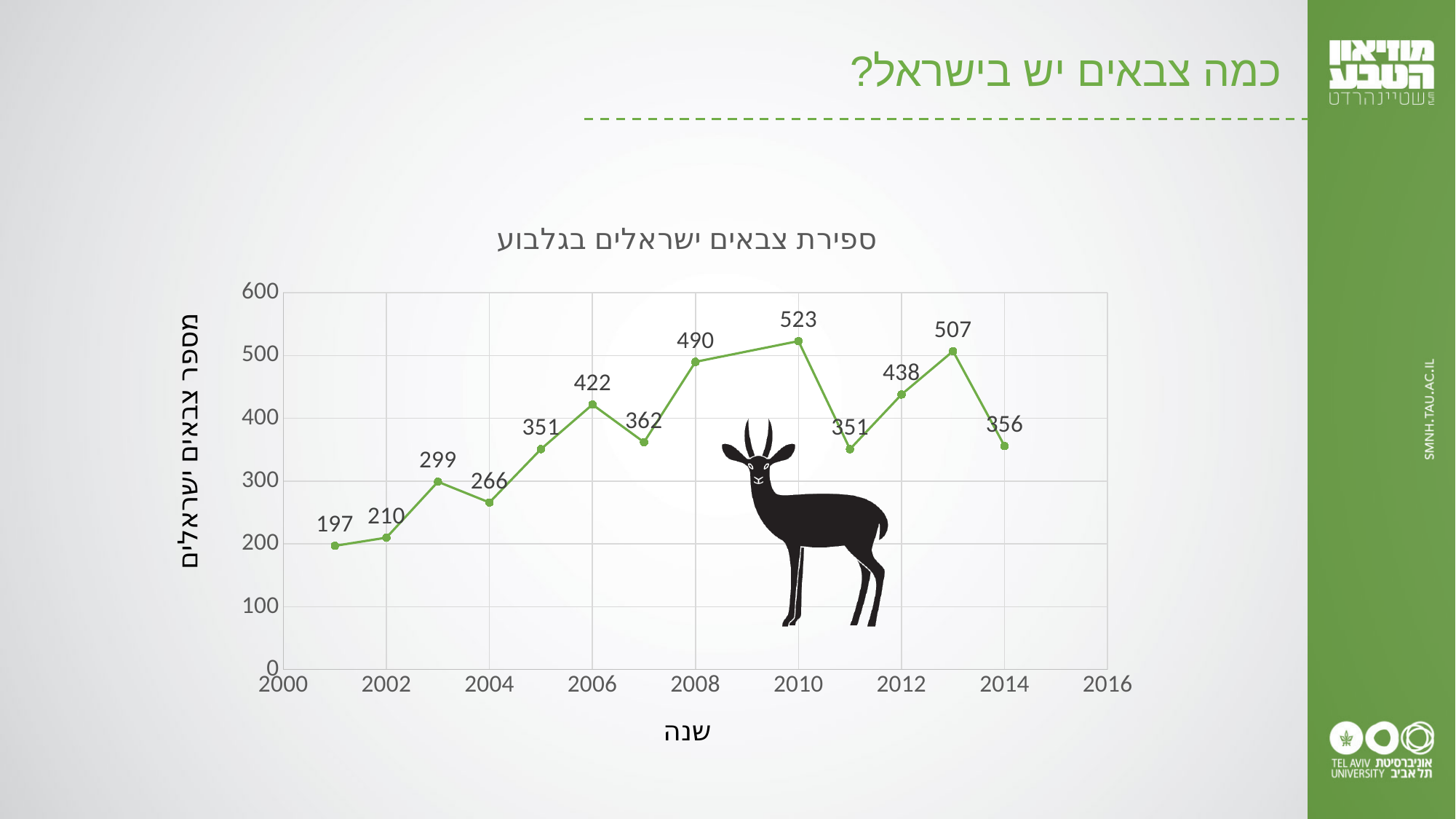
What is the value plotted for the year 2001? 197 What is the difference between the values for 2010 and 2011? 172 Is the value for 2008 greater or less than 400? greater What type of chart is shown on the slide? line chart How many data points are plotted on the chart? 13 Which year has the highest value on the chart? 2010 Which year has the lowest value on the chart? 2001 What is the value plotted for the year 2010? 523 Which is larger, the value for 2006 or the value for 2007? 2006 What is the label of the x axis? שנה What is the value plotted for the year 2013? 507 What is the title of the chart? ספירת צבאים ישראלים בגלבוע